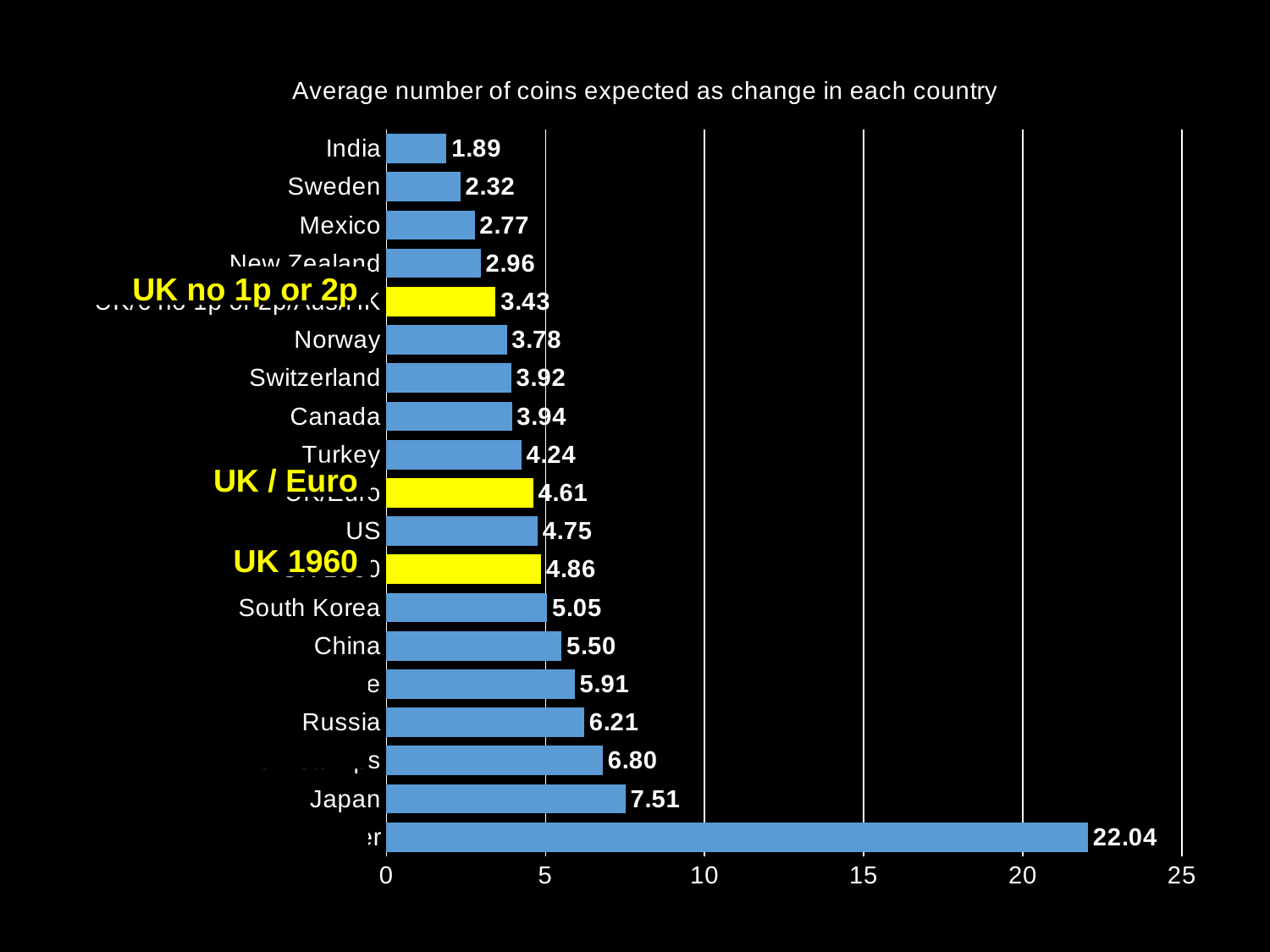
How many bars are plotted on the chart? 19 What is the largest value shown on the chart? 22.04 What type of chart is shown on the slide? bar chart What is the average number of coins expected as change in Japan? 7.51 What is the value shown for UK 1960? 4.86 What is the title of the chart? Average number of coins expected as change in each country How many bars are highlighted in yellow? 3 Which country has the lowest average number of coins expected as change? India What is the value shown for the yellow bar labelled UK / Euro? 4.61 What is the value shown for Canada? 3.94 Which has a higher value, China or South Korea? China What is the difference between the values for Japan and Russia? 1.30